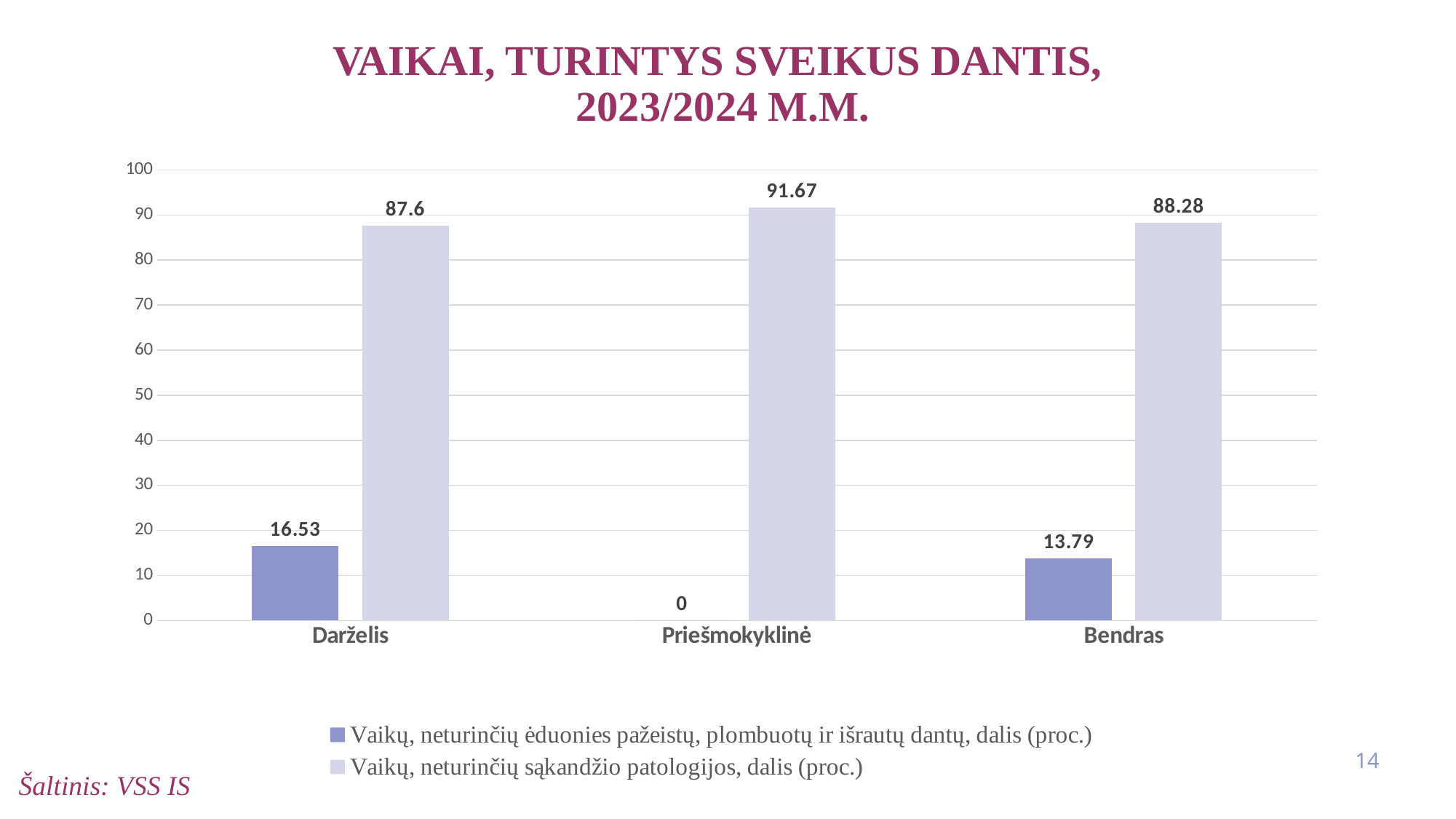
What is the value for Darželis in the series 'Vaikų, neturinčių ėduonies pažeistų, plombuotų ir išrautų dantų, dalis (proc.)'? 16.53 What is the value for Priešmokyklinė in the series 'Vaikų, neturinčių sąkandžio patologijos, dalis (proc.)'? 91.67 What is the value for Bendras in the series 'Vaikų, neturinčių ėduonies pažeistų, plombuotų ir išrautų dantų, dalis (proc.)'? 13.79 Which category has the lowest value in the series 'Vaikų, neturinčių ėduonies pažeistų, plombuotų ir išrautų dantų, dalis (proc.)'? Priešmokyklinė What is the title of the chart? VAIKAI, TURINTYS SVEIKUS DANTIS, 2023/2024 M.M. What is the value for Priešmokyklinė in the series 'Vaikų, neturinčių ėduonies pažeistų, plombuotų ir išrautų dantų, dalis (proc.)'? 0 What kind of chart is shown on the slide? Bar chart What is the difference between the two series values for Darželis? 71.07 Which category has the highest value in the series 'Vaikų, neturinčių sąkandžio patologijos, dalis (proc.)'? Priešmokyklinė Which is larger for Bendras: the 'ėduonies' series value or the 'sąkandžio patologijos' series value? Vaikų, neturinčių sąkandžio patologijos, dalis (proc.) How many series does the legend list? 2 How many categories are shown on the x axis? 3